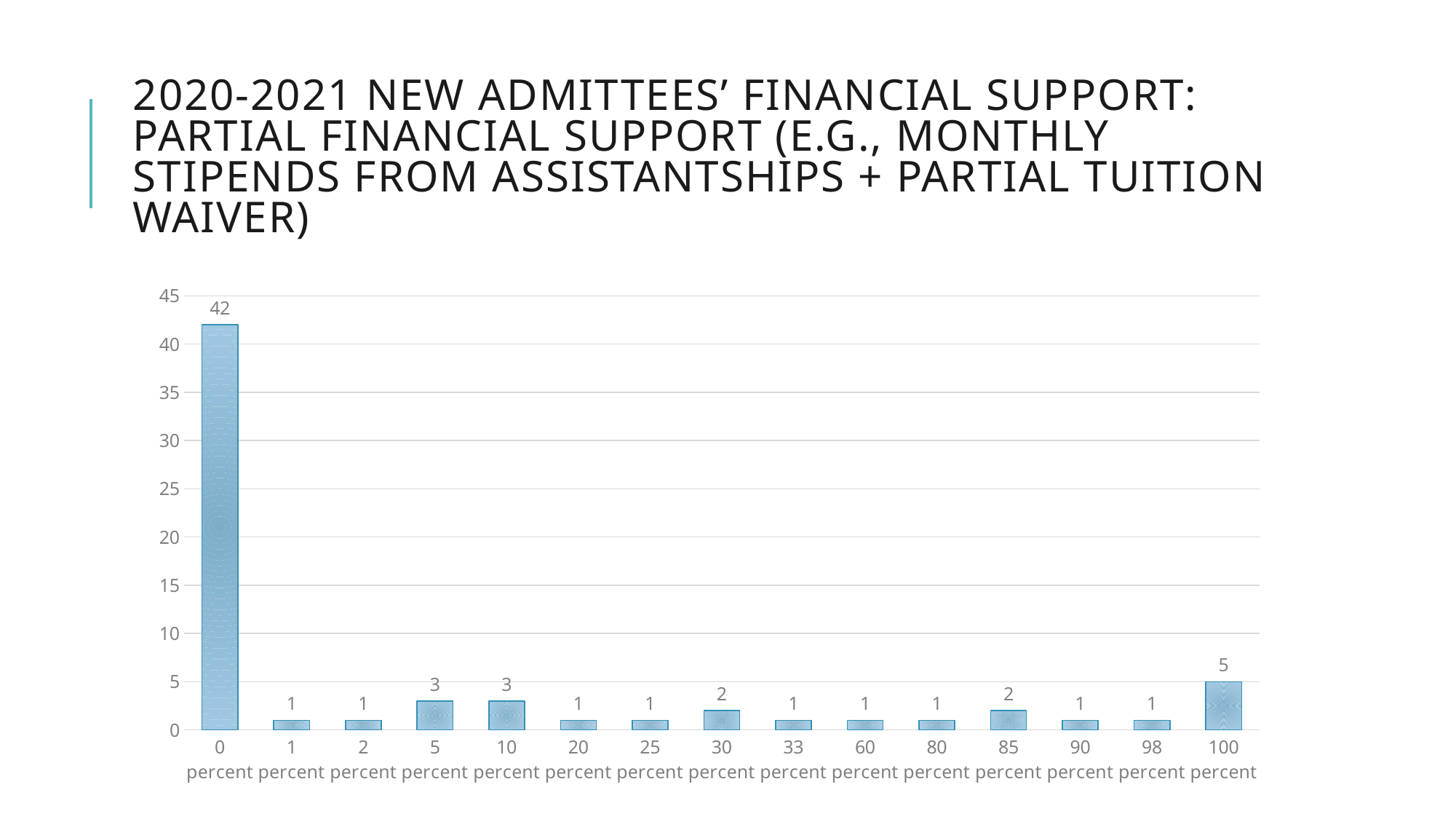
Is the value for 0 percent greater or less than 40? greater What is the value for the 5 percent category? 3 What is the value for the 0 percent category? 42 What kind of chart is shown on the slide? bar chart What is the value for the 100 percent category? 5 Which is larger, the value for 10 percent or the value for 85 percent? 10 percent What is the highest value shown on the y axis? 45 How many categories are shown on the x axis? 15 Which category has the highest value? 0 percent What is the difference between the values for 0 percent and 100 percent? 37 What is the difference between the values for 100 percent and 5 percent? 2 What is the value for the 30 percent category? 2